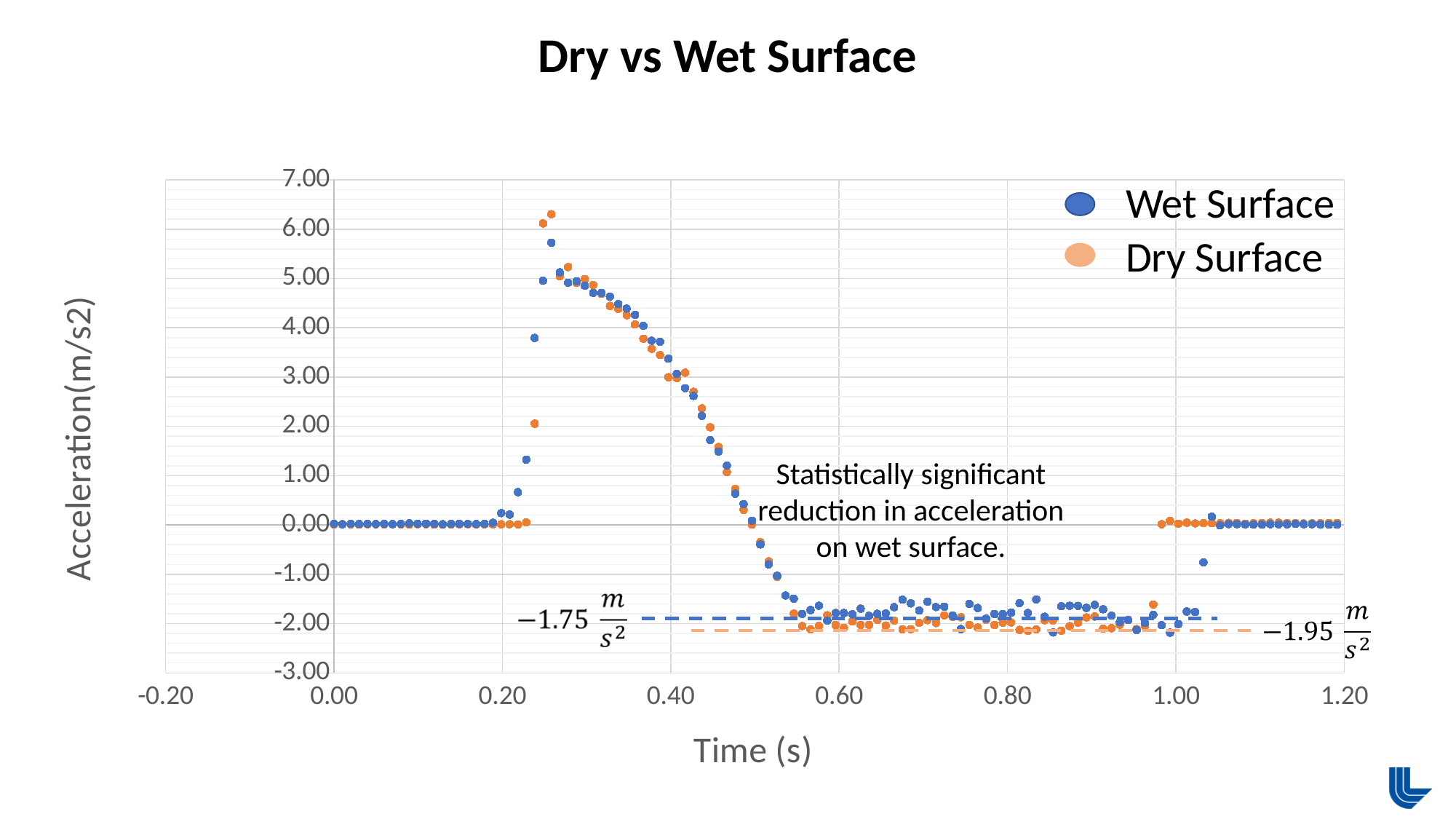
What is the difference between the annotated Dry Surface and Wet Surface average accelerations? 0.20 m/s² What label is on the x axis of the chart? Time (s) What average acceleration value is annotated for the Dry Surface dashed line? -1.95 m/s² What type of chart is shown on the slide? scatter chart Is the peak acceleration of the Wet Surface series greater or less than 6.00? less What is the title of the chart? Dry vs Wet Surface How many series does the legend list? 2 What average acceleration value is annotated for the Wet Surface dashed line? -1.75 m/s² Which series reaches the higher peak acceleration, Wet Surface or Dry Surface? Dry Surface Is the peak acceleration of the Dry Surface series greater or less than 6.00? greater Between 0.30 s and 0.50 s, do the acceleration values rise or fall as time increases? fall Which annotated average acceleration is larger in magnitude, the Wet Surface value or the Dry Surface value? Dry Surface